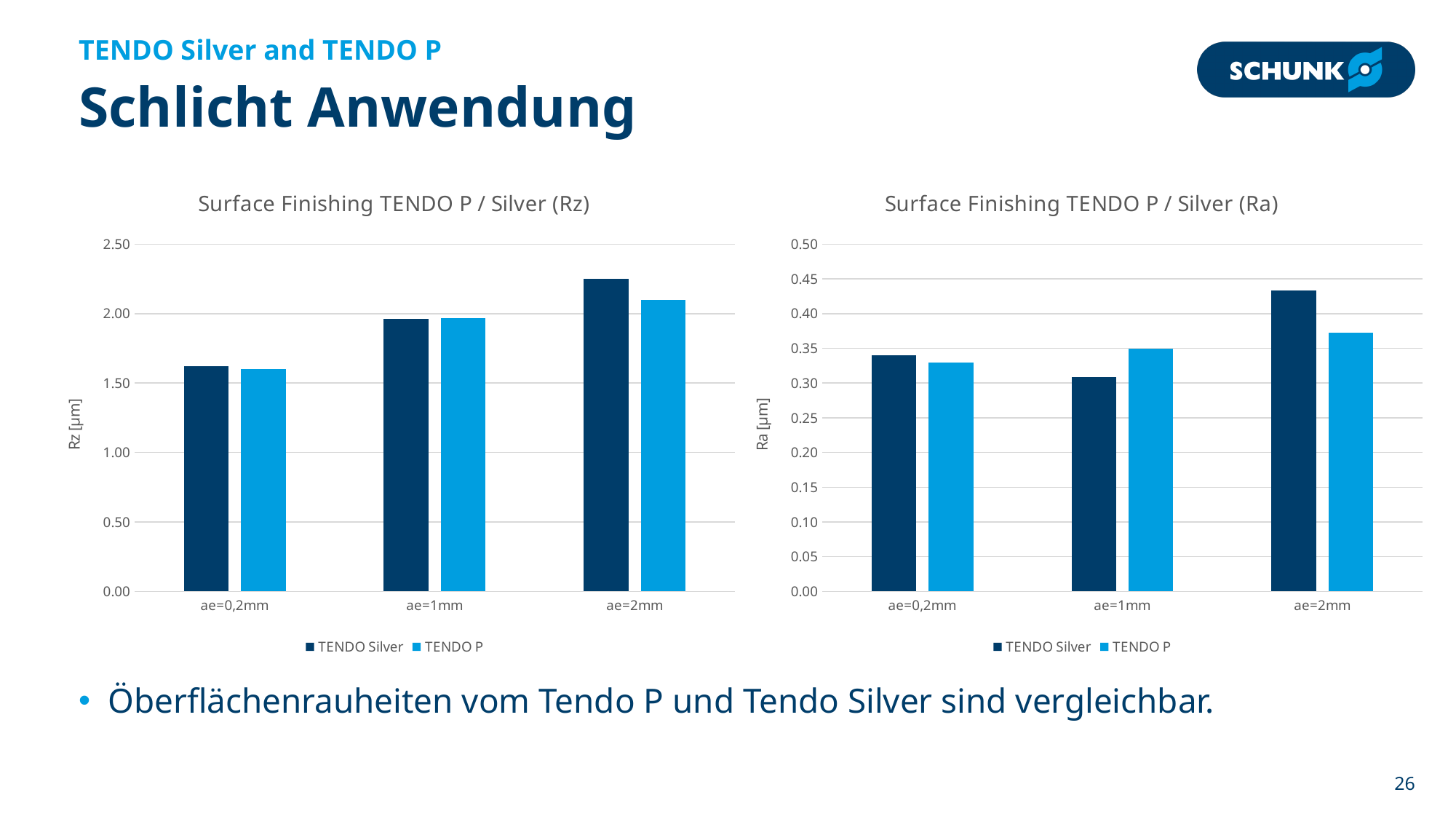
In the "Surface Finishing TENDO P / Silver (Rz)" chart, at ae=2mm, which series has the larger value, TENDO Silver or TENDO P? TENDO Silver In the "Surface Finishing TENDO P / Silver (Ra)" chart, how many categories are shown on the x axis? 3 What is the y-axis label of the "Surface Finishing TENDO P / Silver (Ra)" chart on the right? Ra [µm] In the "Surface Finishing TENDO P / Silver (Ra)" chart, which category has the lowest TENDO Silver value? ae=1mm In the "Surface Finishing TENDO P / Silver (Rz)" chart, is the TENDO Silver value for ae=2mm greater or less than 2.00? greater In the "Surface Finishing TENDO P / Silver (Rz)" chart, is the TENDO P value for ae=0,2mm greater or less than 2.00? less What kind of chart is the "Surface Finishing TENDO P / Silver (Rz)" chart on the left? bar chart In the "Surface Finishing TENDO P / Silver (Rz)" chart, how many series does the legend list? 2 In the "Surface Finishing TENDO P / Silver (Rz)" chart, which category has the highest TENDO Silver value? ae=2mm In the "Surface Finishing TENDO P / Silver (Rz)" chart, do the TENDO Silver values rise or fall from ae=0,2mm to ae=2mm? rise In the "Surface Finishing TENDO P / Silver (Ra)" chart, at ae=1mm, which series has the larger value, TENDO Silver or TENDO P? TENDO P In the "Surface Finishing TENDO P / Silver (Ra)" chart, is the TENDO Silver value for ae=2mm greater or less than 0.40? greater